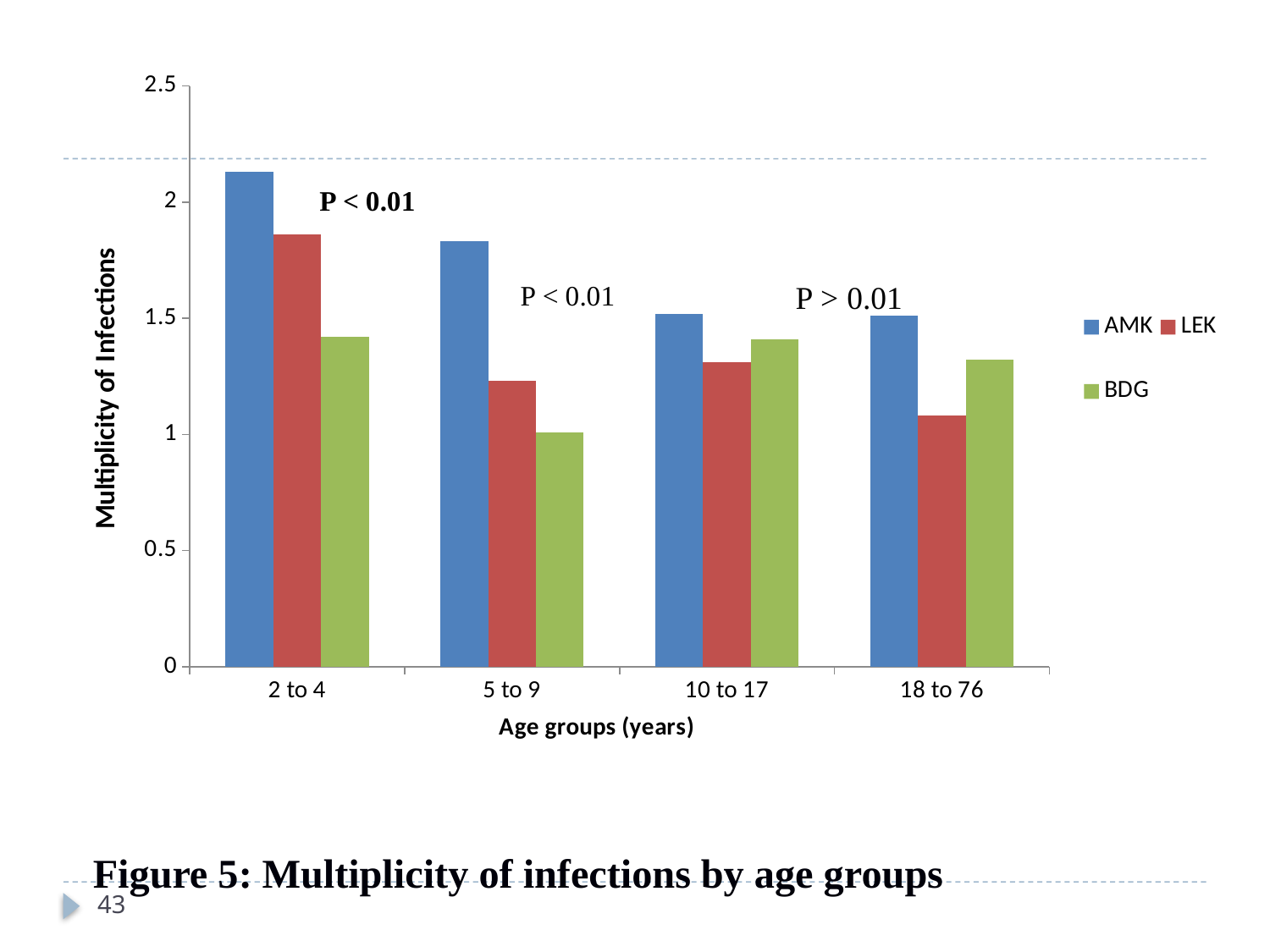
What is the title of the y axis? Multiplicity of Infections How many series does the legend list? 3 Which age group has the lowest LEK value? 18 to 76 What kind of chart is shown on the slide? Bar chart Which age group has the highest AMK value? 2 to 4 Which age group has the lowest BDG value? 5 to 9 Is the AMK value for the 5 to 9 age group greater or less than 1.5? greater Do the AMK values generally rise or fall as the age groups increase along the x axis? fall Is the AMK value for the 2 to 4 age group greater or less than 2? greater In the 10 to 17 age group, which is larger, the LEK value or the BDG value? BDG Is the LEK value for the 5 to 9 age group greater or less than 1.5? less How many age groups are shown on the x axis? 4